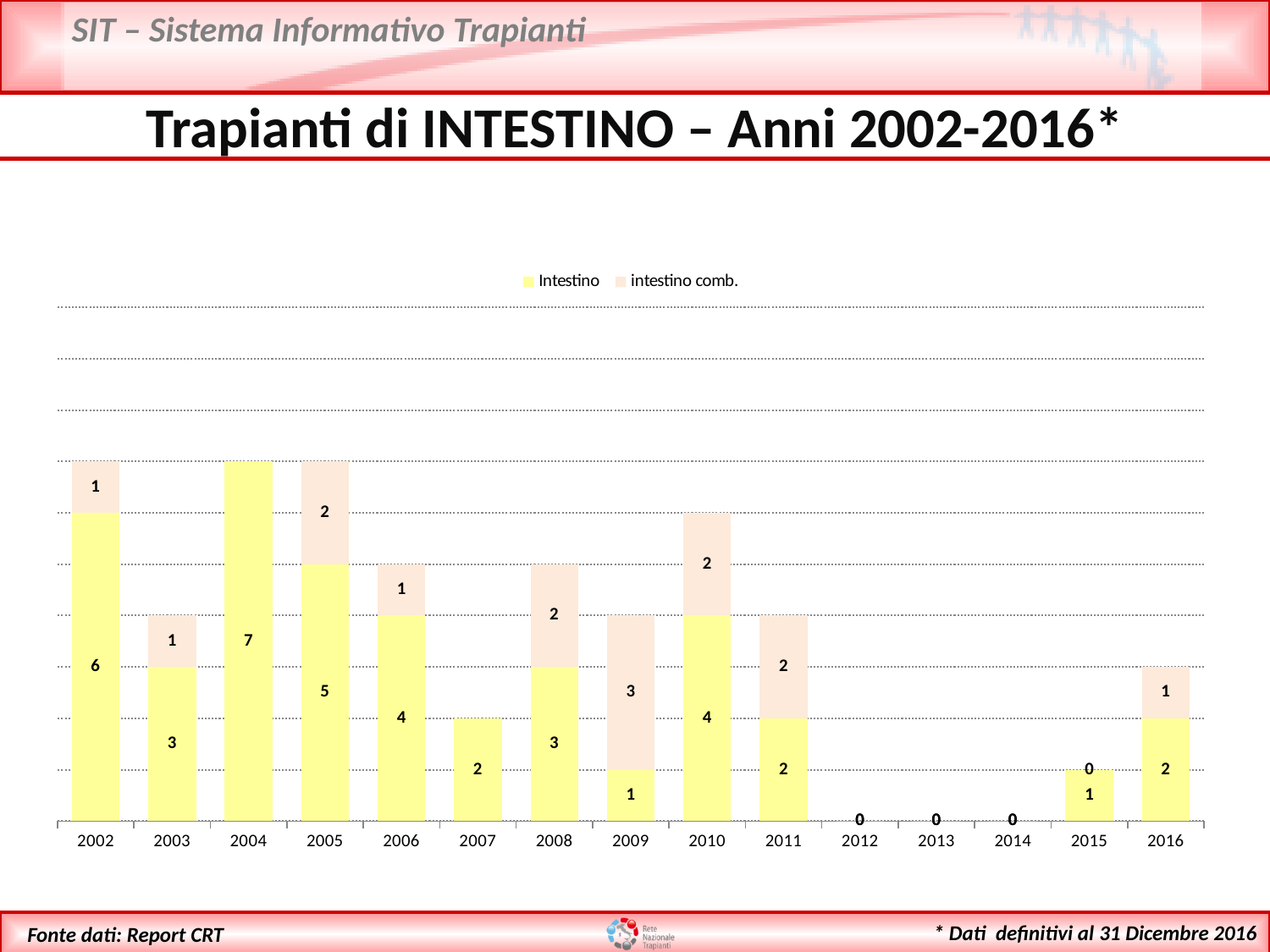
What is the total of the stacked bar for 2005? 7 How many years are shown on the x axis? 15 What is the difference between the Intestino values for 2002 and 2003? 3 Which is larger, the Intestino value for 2010 or the Intestino value for 2011? 2010 What is the intestino comb. value for 2009? 3 How many series does the legend list? 2 What kind of chart is shown on the slide? Stacked bar chart What is the total of the stacked bar for 2011? 4 What is the title of the slide? Trapianti di INTESTINO – Anni 2002-2016* What is the Intestino value for 2002? 6 What is the Intestino value for 2016? 2 Which year has the highest Intestino value? 2004